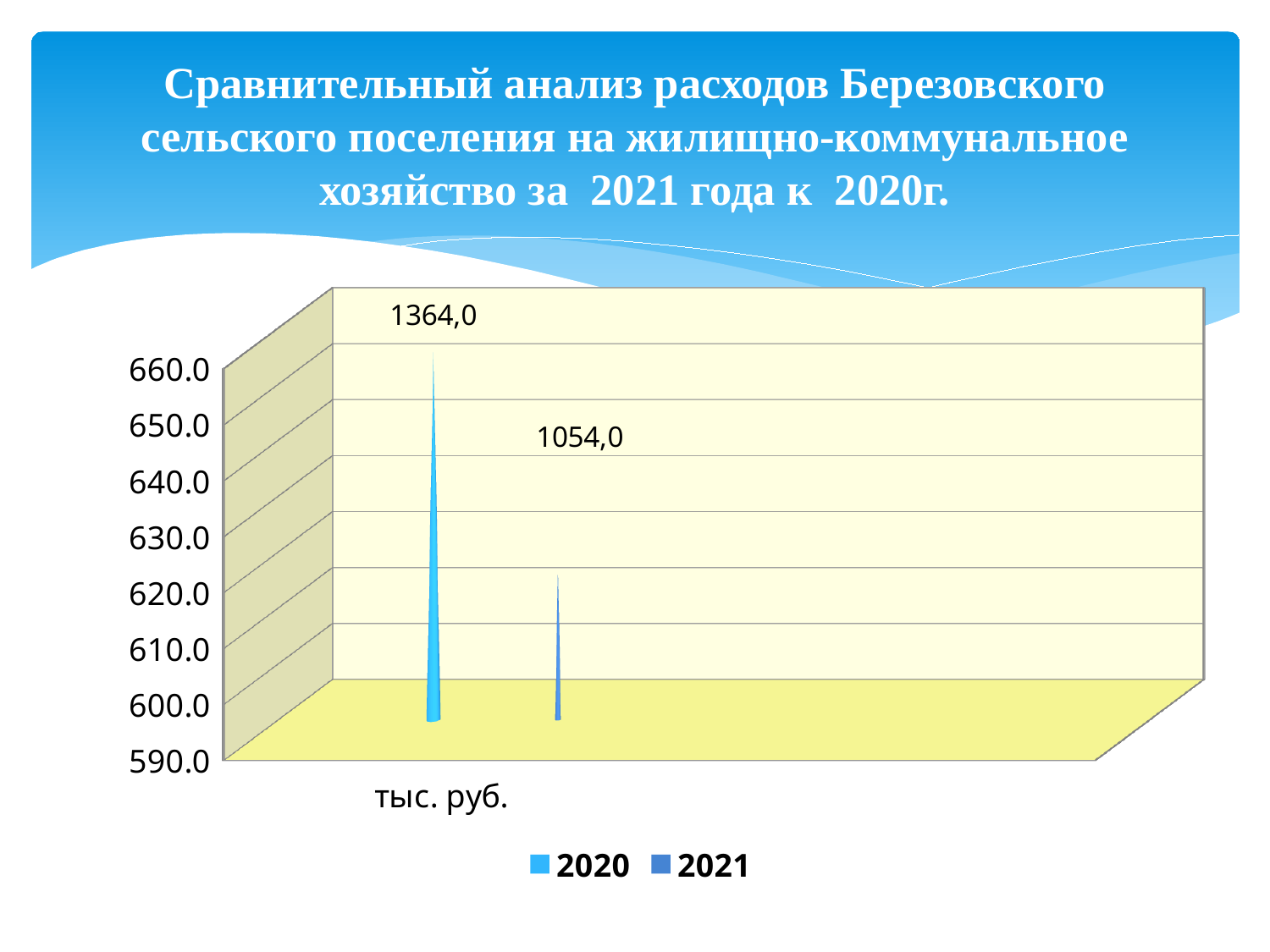
Which year has the higher value, 2020 or 2021? 2020 Did the expenditure rise or fall from 2020 to 2021? fall What kind of chart is shown on the slide? bar chart What are the two entries listed in the legend? 2020 and 2021 Which series has the highest value on the chart? 2020 What is the category label shown on the x axis? тыс. руб. How many categories are shown on the x axis? 1 How many series does the legend list? 2 Which series has the lowest value on the chart? 2021